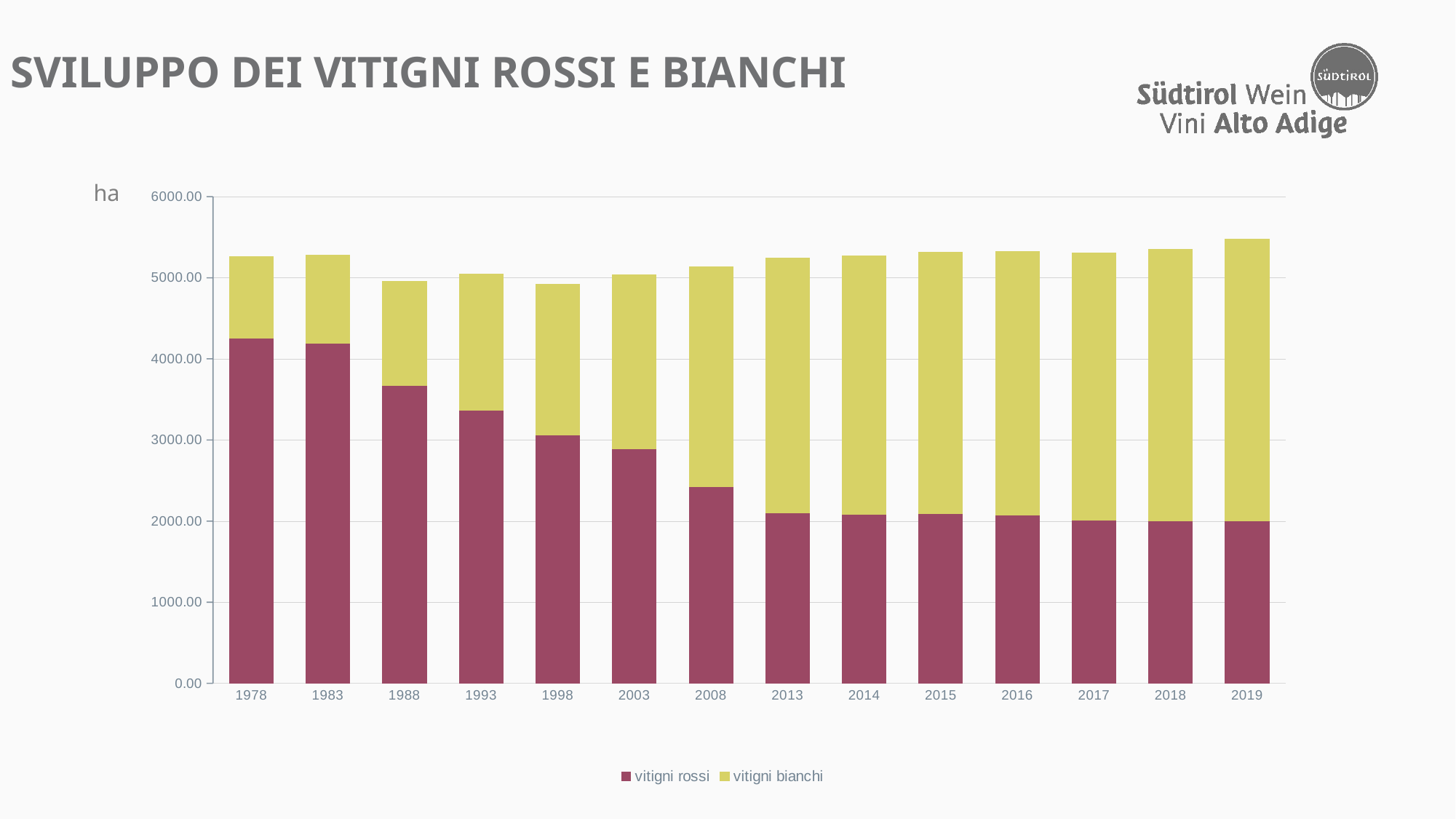
Do the values for vitigni rossi rise or fall from 1978 to 2019? fall Is the value for vitigni rossi in 2019 greater or less than 3000? less Which year has the highest value for vitigni bianchi? 2019 In 2019, which series has the larger value, vitigni rossi or vitigni bianchi? vitigni bianchi What kind of chart is shown on the slide? stacked bar chart Which year has the tallest stacked bar (largest total)? 2019 How many years are shown on the x axis of the chart? 14 Is the value for vitigni rossi in 1978 greater or less than 4000? greater Is the value for vitigni bianchi in 2019 greater or less than 3000? greater How many series does the chart's legend list? 2 In 1978, which series has the larger value, vitigni rossi or vitigni bianchi? vitigni rossi